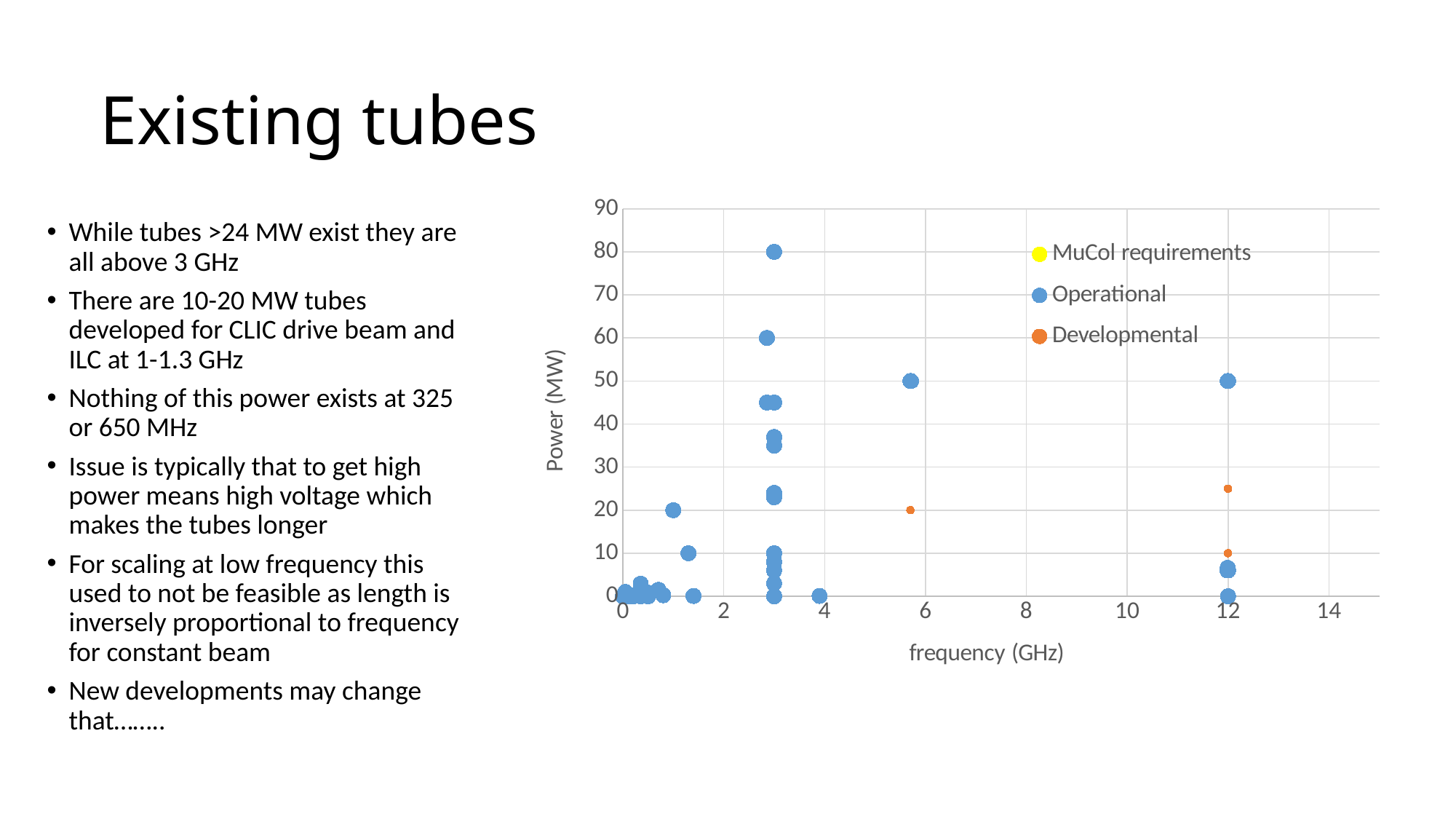
What is the highest power value plotted on the chart? 80 Is the Operational point plotted near 1 GHz greater or less than 30 MW? less What kind of chart is shown on the slide? scatter chart Is the highest Operational point on the chart greater or less than 70 MW? greater What is the label of the x axis of the chart? frequency (GHz) Is the highest Operational point plotted near 12 GHz greater or less than 40 MW? greater How many series does the chart legend list? 3 What is the label of the y axis of the chart? Power (MW) Which series reaches a higher power value on the chart, Operational or Developmental? Operational